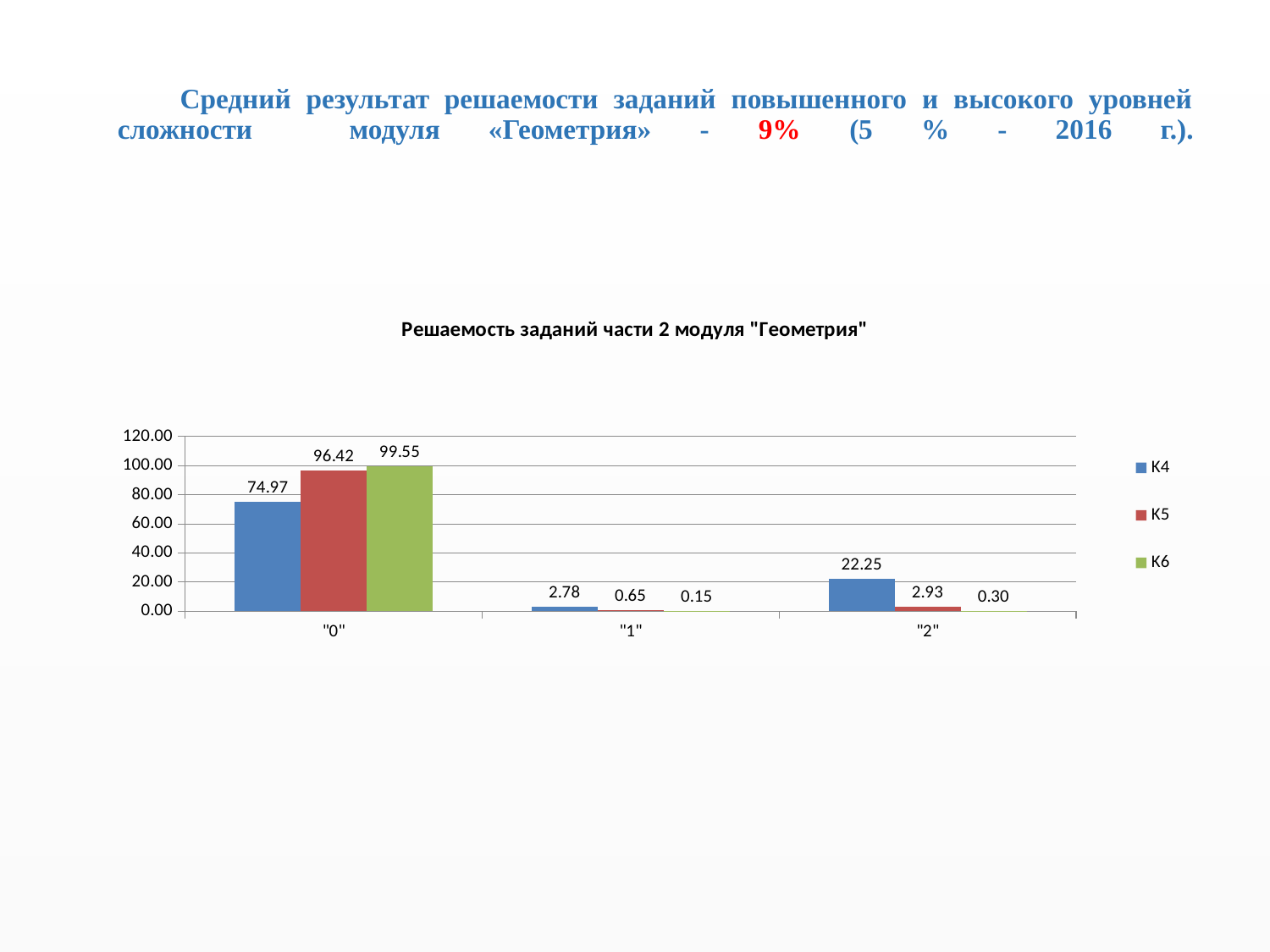
What is the value for К4 in category "0"? 74.97 What is the title of the chart? Решаемость заданий части 2 модуля "Геометрия" How many series does the legend list? 3 Which series has the highest value in category "0"? К6 What is the value for К5 in category "2"? 2.93 What is the value for К6 in category "0"? 99.55 Which series has the lowest value in category "2"? К6 What kind of chart is shown? Bar chart What is the value for К6 in category "1"? 0.15 What is the difference between the К6 and К4 values in category "0"? 24.58 Which is larger: the К4 value in category "2" or the К4 value in category "1"? К4 in category "2" How many categories are shown on the x axis? 3